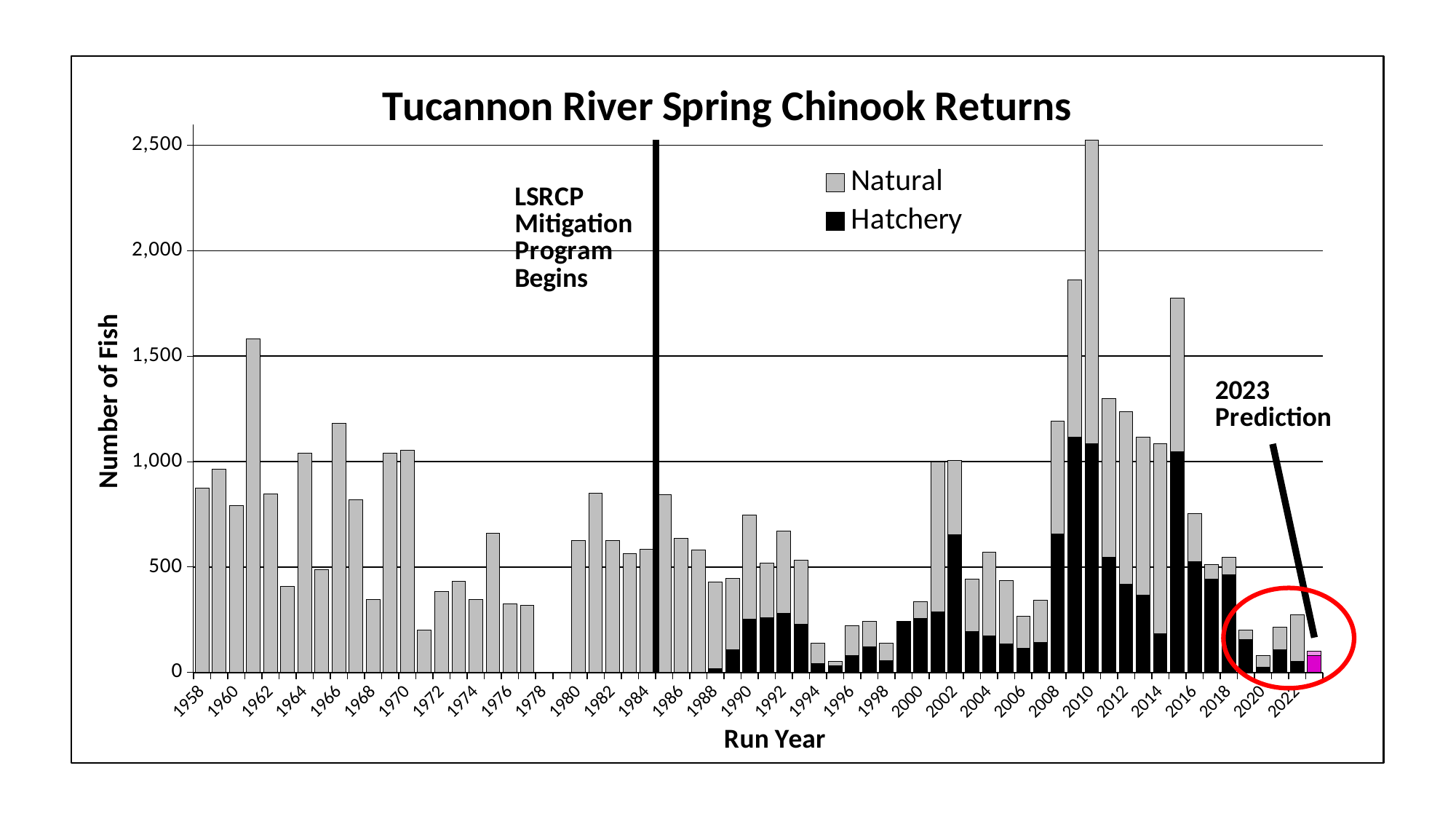
What is the title of the chart? Tucannon River Spring Chinook Returns Is the total value for 1962 greater or less than 1,500? less Which has the larger total return, 1962 or 1966? 1966 Which has the larger total return, 2015 or 2016? 2015 Do the total returns rise or fall from 2010 to 2020? fall What kind of chart is shown on the slide? Stacked bar chart Is the Hatchery value for 2010 greater or less than 1,000? greater Is the total value for 2010 greater or less than 2,000? greater What event does the vertical black line on the chart mark? LSRCP Mitigation Program Begins Which run year has the highest total return? 2010 How many series does the legend list? 2